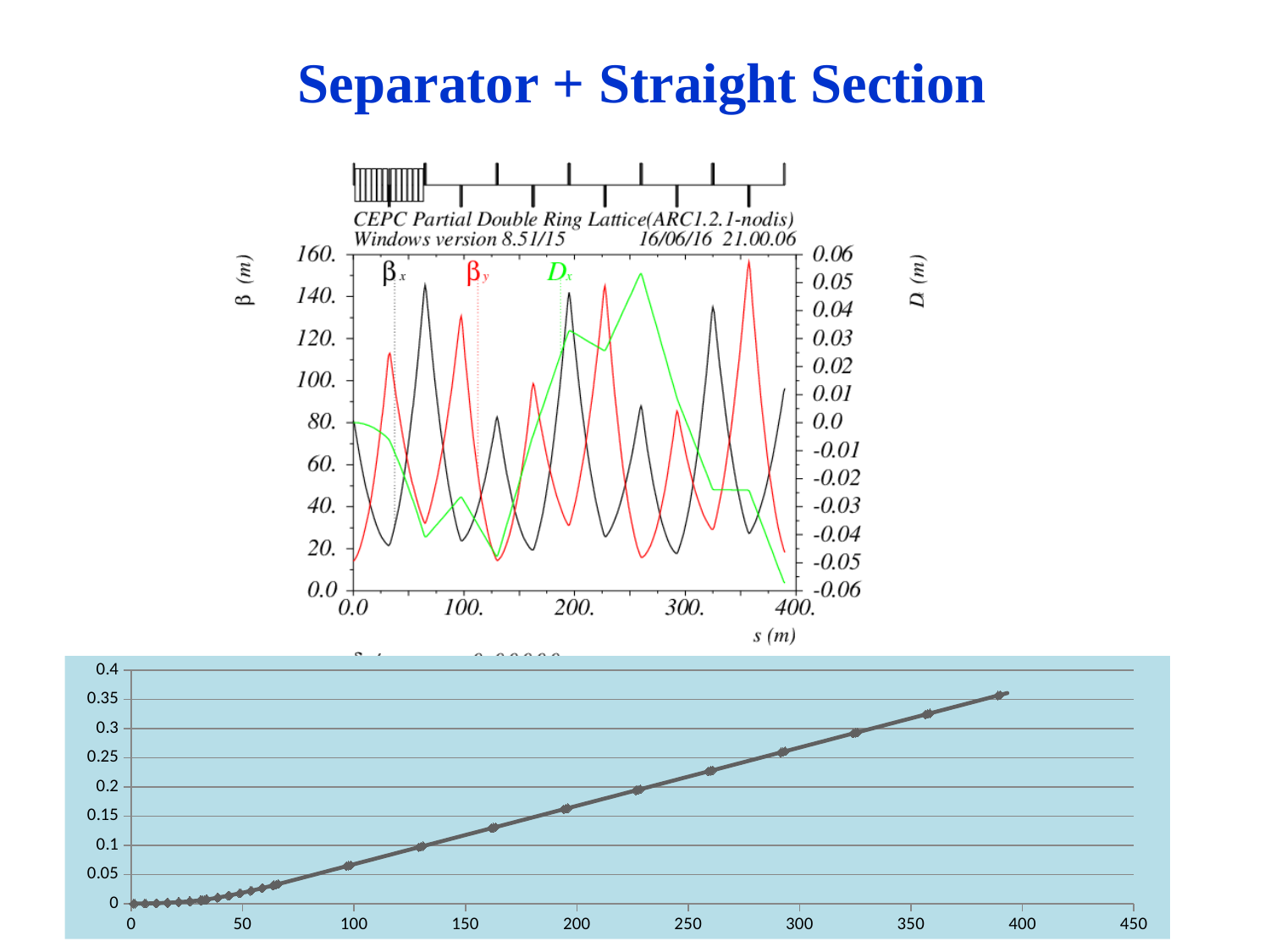
In the top chart (CEPC Partial Double Ring Lattice), is the peak of the green Dx curve near s = 260 greater or less than 0.04? greater In the bottom chart, is the value at x = 100 greater or less than 0.1? less In the top chart (CEPC Partial Double Ring Lattice), is the peak of the red βy curve near s = 360 greater or less than 140? greater In the top chart (CEPC Partial Double Ring Lattice), how many curves are plotted? 3 What is the label of the x axis of the top chart? s (m) In the bottom chart, do the values rise or fall as the x axis increases from 0 to 400? rise How many lines (series) are plotted in the bottom chart? 1 What kind of chart is the bottom chart on the slide? line chart In the top chart, which colour is used for the Dx curve? green